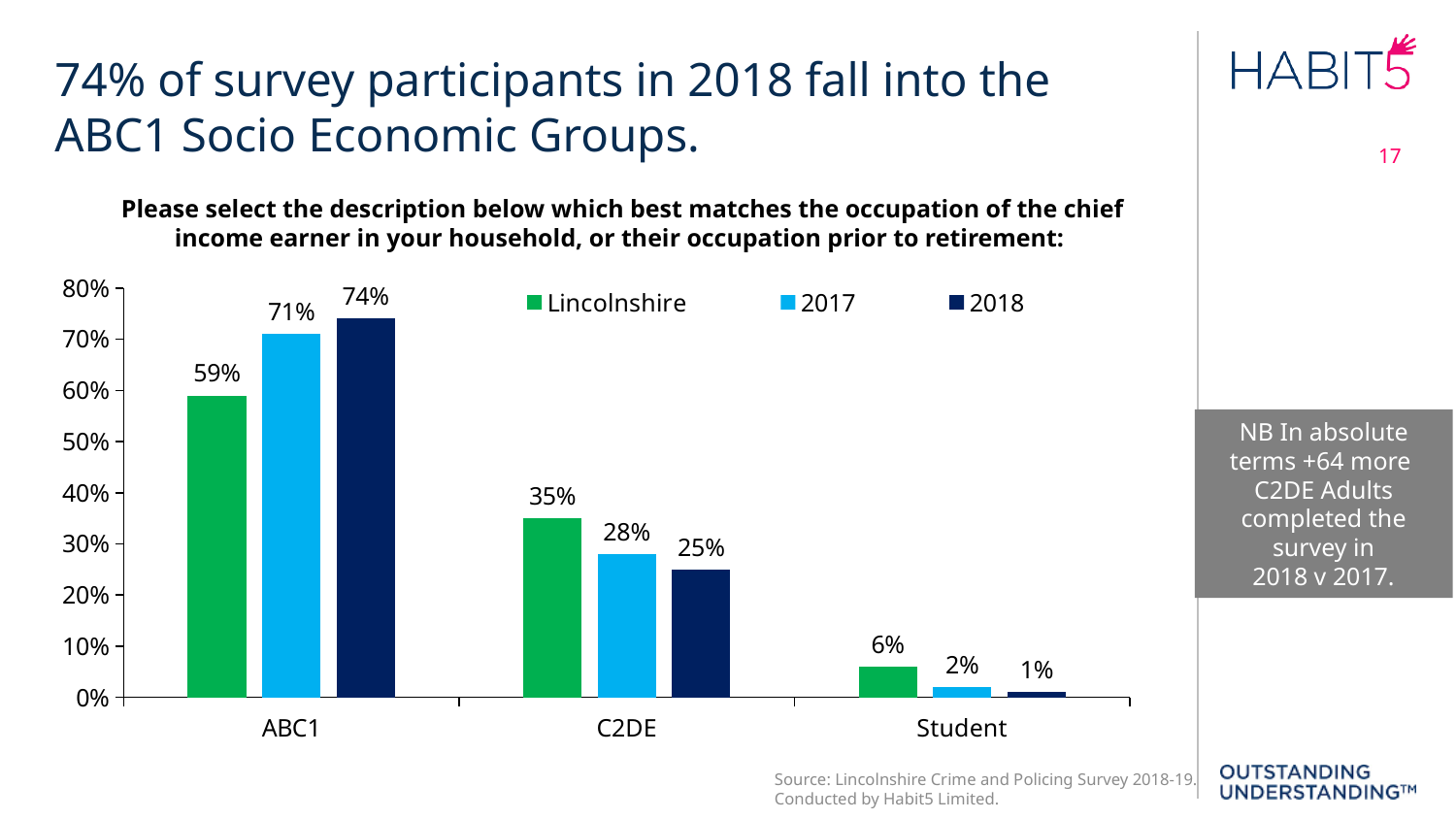
Which category has the lowest Lincolnshire value? Student Which is larger for C2DE: the 2017 value or the 2018 value? 2017 Which series is shown in green in the legend? Lincolnshire What is the difference between the Lincolnshire and 2018 values for C2DE? 10% Which category has the highest 2018 value? ABC1 What kind of chart is shown on the slide? Bar chart What is the Lincolnshire value for C2DE? 35% What is the 2017 value for Student? 2% How many categories are shown on the x axis? 3 What is the difference between the 2018 and 2017 values for ABC1? 3% How many series does the legend list? 3 What is the 2018 value for ABC1? 74%